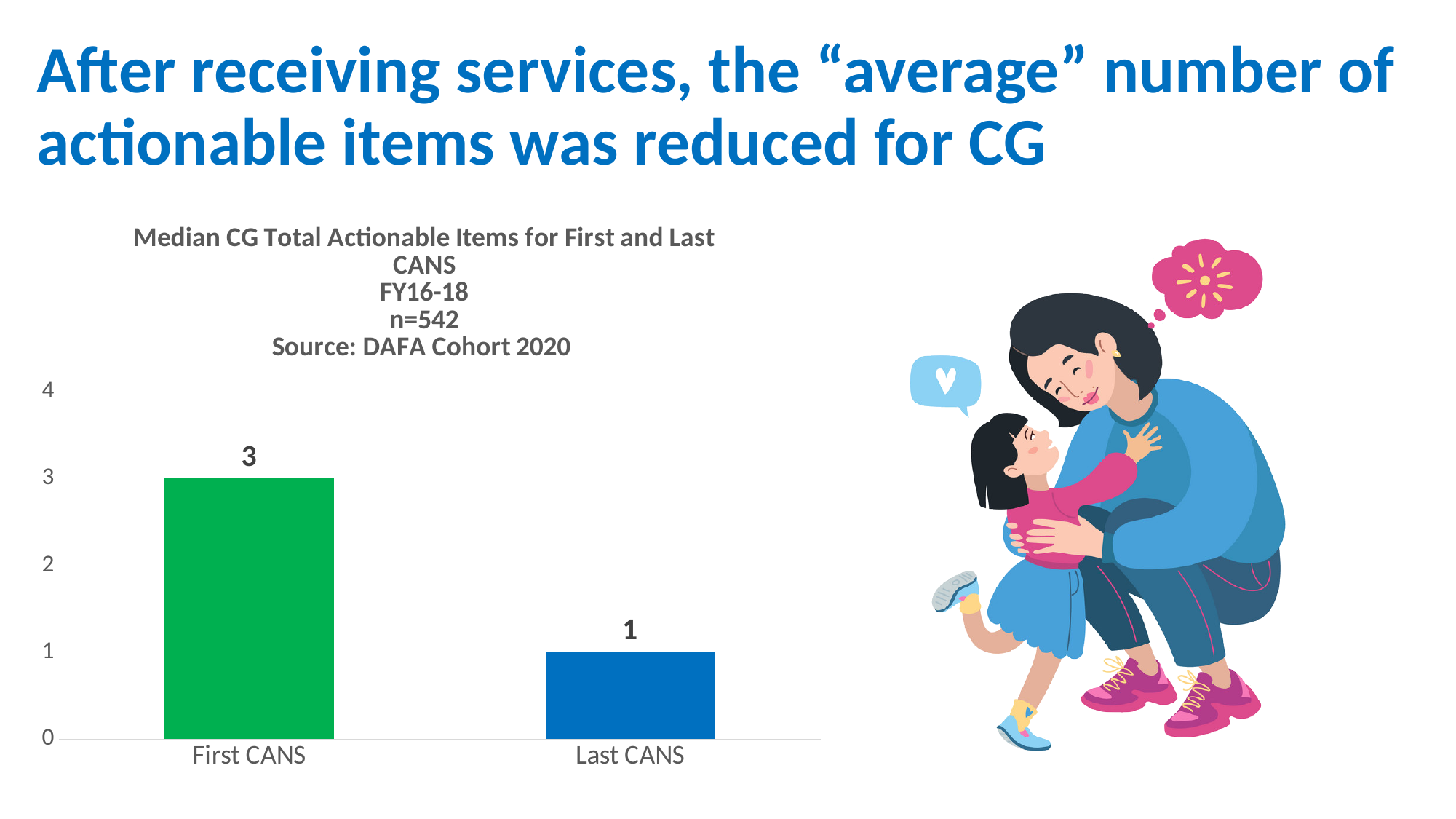
What is the median CG total actionable items value for First CANS? 3 Which category has the lowest value on the chart? Last CANS What is the median CG total actionable items value for Last CANS? 1 Is the value for Last CANS greater or less than 2? less What is the difference between the First CANS and Last CANS values? 2 How many categories are shown on the chart? 2 What sample size (n) is stated in the chart title? n=542 Which category has the higher value, First CANS or Last CANS? First CANS What kind of chart is shown on the slide? Bar chart Is the value for First CANS greater or less than 2? greater Do the values rise or fall from First CANS to Last CANS? Fall Which category has the highest value on the chart? First CANS